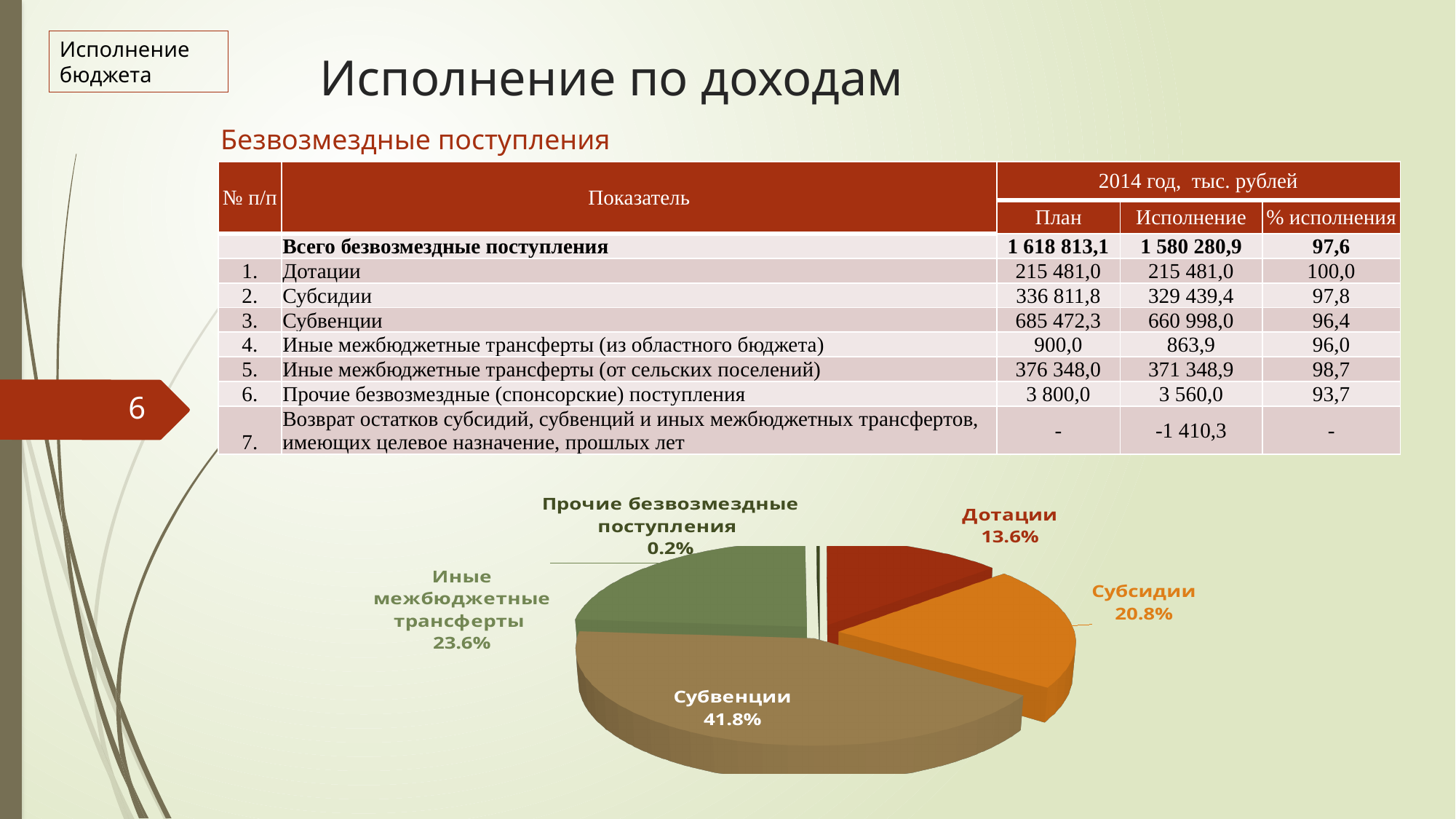
What share of the pie chart does Субвенции have? 41.8% What kind of chart is shown on the slide? Pie chart How many slices does the pie chart have? 5 In the pie chart, what colour is the Субвенции slice? Brown Which slice of the pie chart is the largest? Субвенции Which slice of the pie chart is the smallest? Прочие безвозмездные поступления In the pie chart, what is the difference in percentage points between Субвенции and Дотации? 28.2 What share of the pie chart does Субсидии have? 20.8% What share of the pie chart does Иные межбюджетные трансферты have? 23.6% In the pie chart, which is larger: Субсидии or Иные межбюджетные трансферты? Иные межбюджетные трансферты